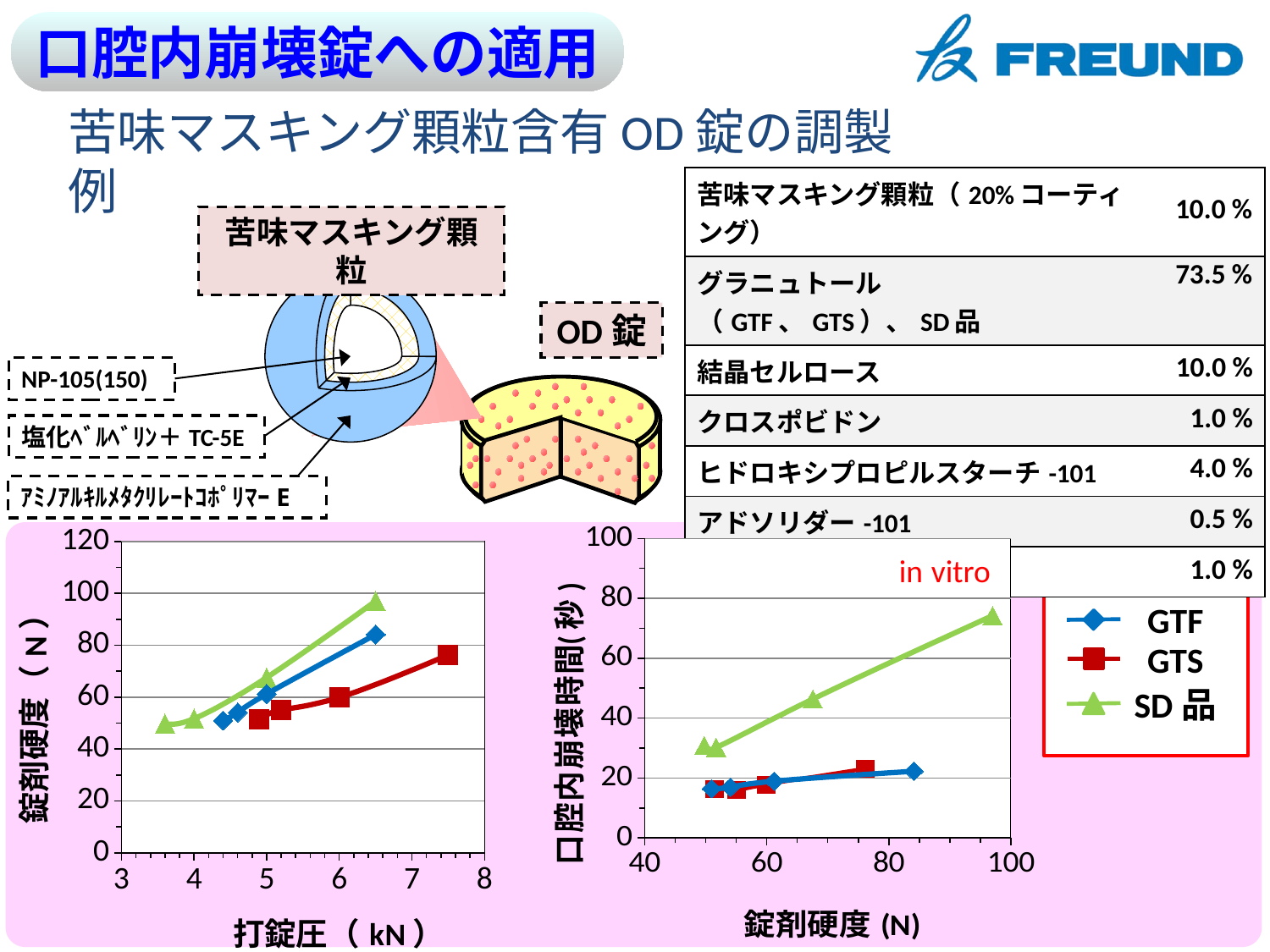
In the right chart (口腔内崩壊時間 vs 錠剤硬度), is the disintegration time of SD品 at its highest hardness greater or less than 60 seconds? greater In the right chart (口腔内崩壊時間 vs 錠剤硬度), does the disintegration time of SD品 rise or fall as tablet hardness increases? rise What annotation is printed in red inside the right chart's plot area? in vitro How many series does the legend list for the charts? 3 In the left chart (錠剤硬度 vs 打錠圧), which series reaches the highest tablet hardness? SD品 In the right chart (口腔内崩壊時間 vs 錠剤硬度), which series has the longest disintegration time? SD品 In the left chart (錠剤硬度 vs 打錠圧), is the hardness of GTS at its highest pressing pressure greater or less than 60 N? greater What kind of chart is the left chart (錠剤硬度 vs 打錠圧)? line chart In the left chart (錠剤硬度 vs 打錠圧), is the hardness of SD品 at its highest pressing pressure greater or less than 80 N? greater In the left chart (錠剤硬度 vs 打錠圧), at about 6.5 kN, which series has the higher hardness, SD品 or GTF? SD品 In the left chart (錠剤硬度 vs 打錠圧), does tablet hardness rise or fall as 打錠圧 increases? rise